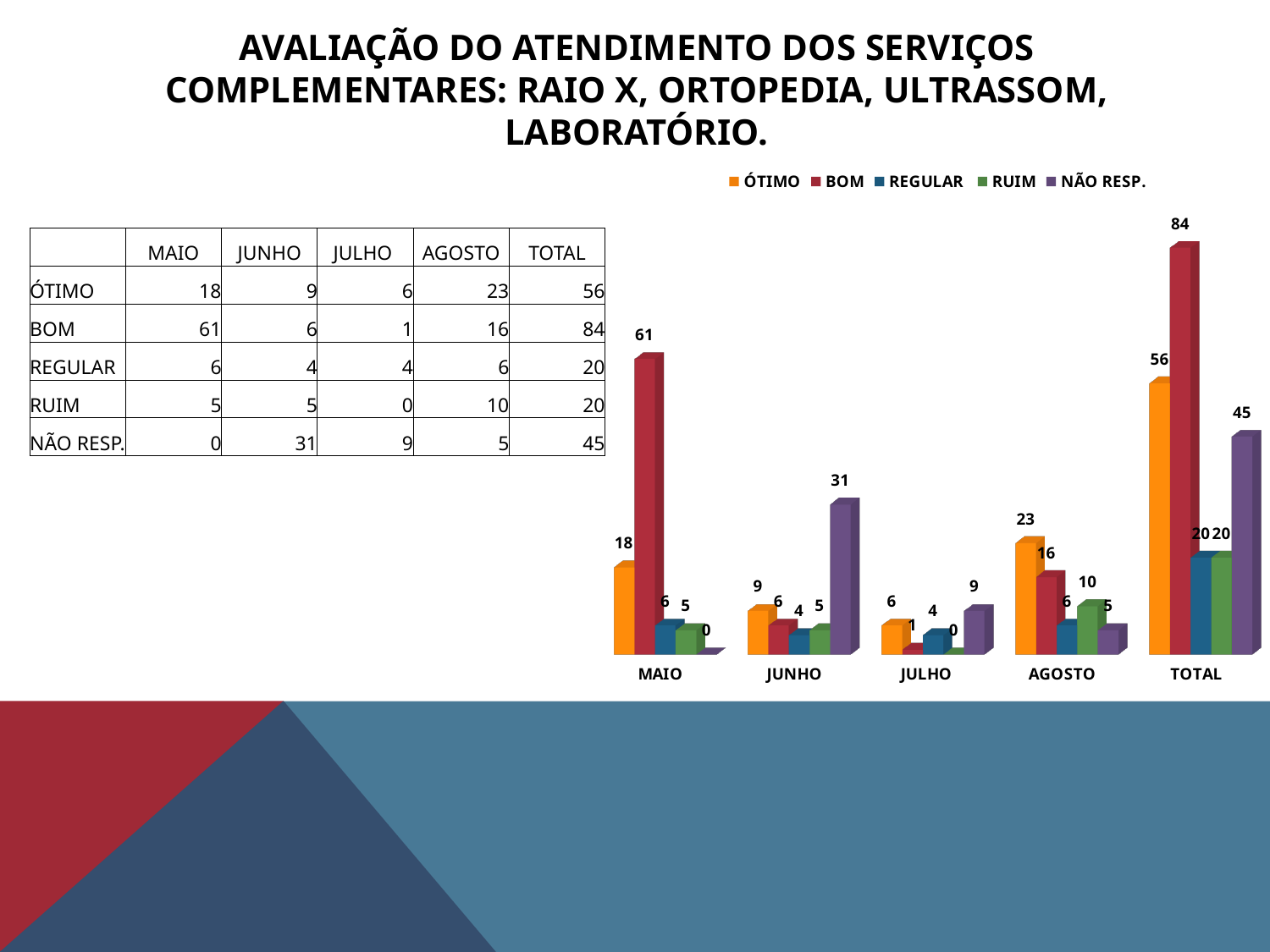
What is the TOTAL value for BOM? 84 What is the difference between the BOM and ÓTIMO values in MAIO? 43 Which is larger in JUNHO, ÓTIMO or NÃO RESP.? NÃO RESP. What is the value for NÃO RESP. in JUNHO? 31 What is the value for ÓTIMO in AGOSTO? 23 Which series has the highest value in the TOTAL category? BOM What is the value for BOM in MAIO? 61 What is the total of the five series in AGOSTO? 60 How many categories are shown on the x axis? 5 What kind of chart is shown? bar chart Which series has the lowest value in MAIO? NÃO RESP. How many series does the legend list? 5